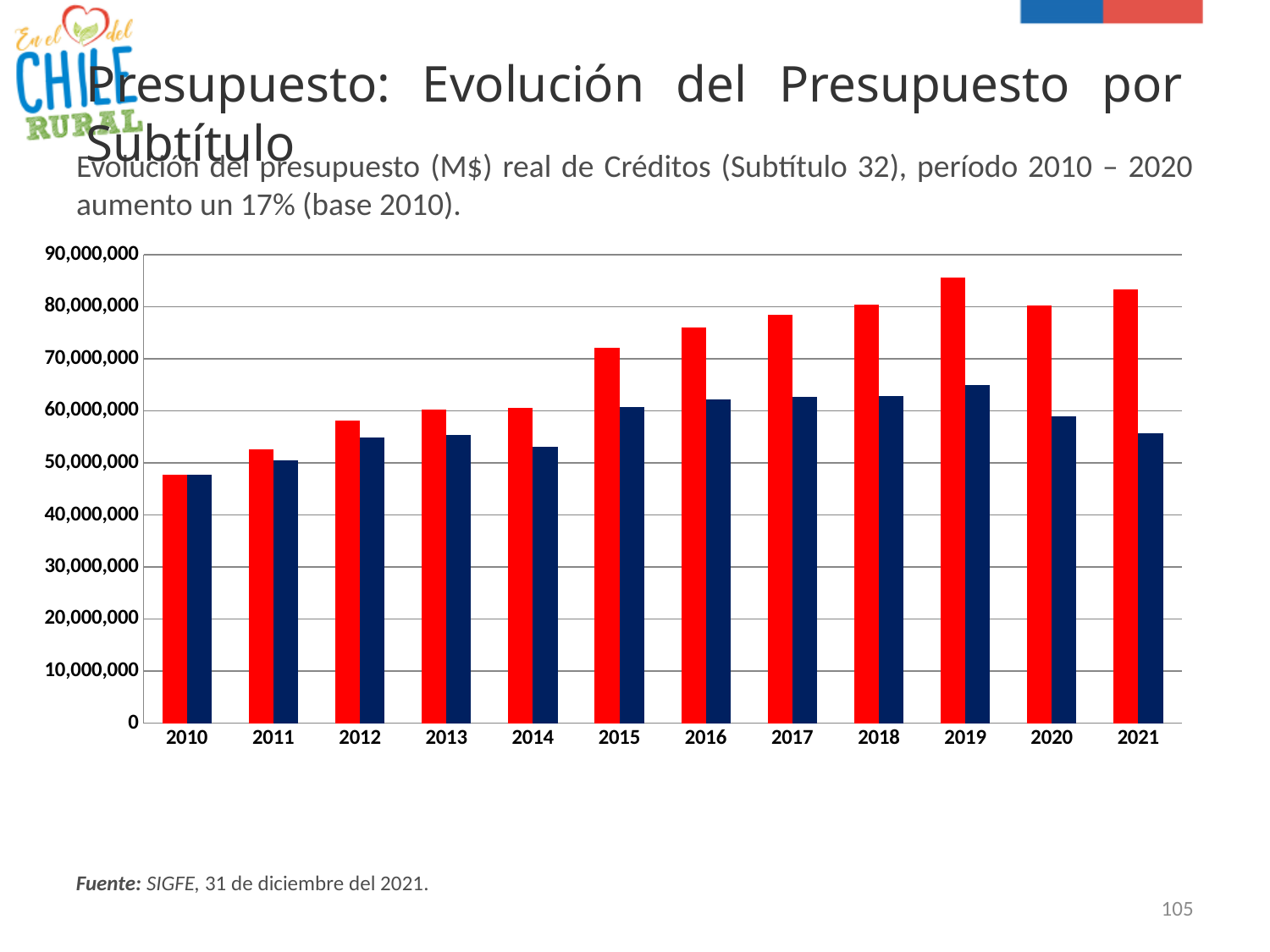
How many years are shown on the x axis of the chart? 12 What kind of chart is shown on the slide? bar chart Is the value of the red bar for 2010 greater or less than 50,000,000? less In which year is the red bar the tallest? 2019 Is the value of the red bar for 2015 greater or less than 70,000,000? greater Do the red bars generally rise or fall from 2010 to 2019? rise How many bars are plotted for each year in the chart? 2 For 2021, which bar is taller, the red bar or the dark blue bar? the red bar Is the value of the red bar for 2019 greater or less than 80,000,000? greater In which year is the dark blue bar the tallest? 2019 In which year is the red bar the shortest? 2010